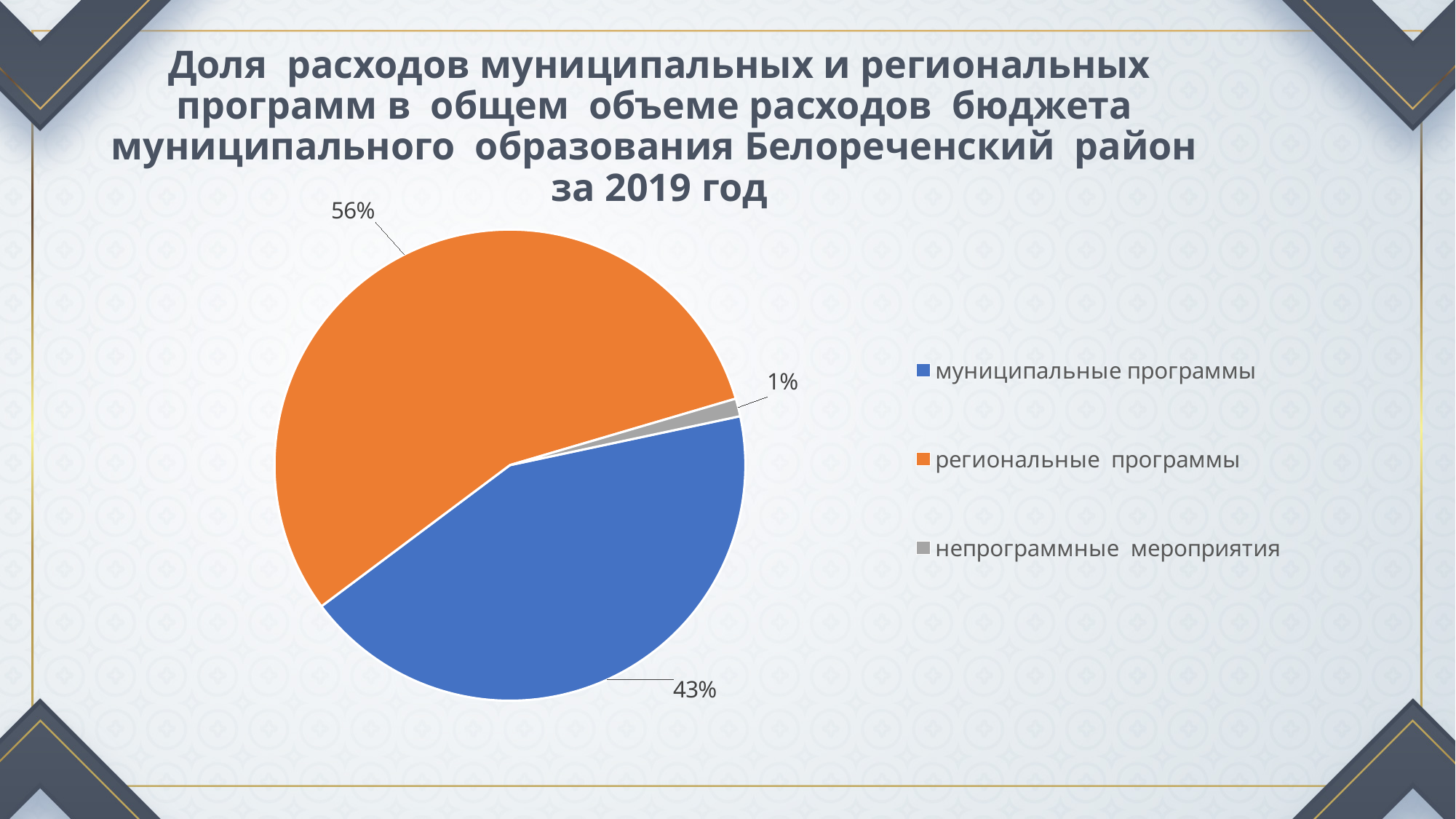
How many slices does the pie chart have? 3 Which category has the largest slice of the pie? региональные программы What share of the pie is labelled for непрограммные мероприятия? 1% What kind of chart is shown on the slide? pie chart What share of the pie is labelled for муниципальные программы? 43% What colour is the slice for муниципальные программы? blue What is the difference in percentage points between региональные программы and муниципальные программы? 13 Which category has the smallest slice of the pie? непрограммные мероприятия How many entries does the legend list? 3 Which year does the chart title say the data is for? 2019 What share of the pie is labelled for региональные программы? 56% Which is larger: the slice for муниципальные программы or the slice for региональные программы? региональные программы